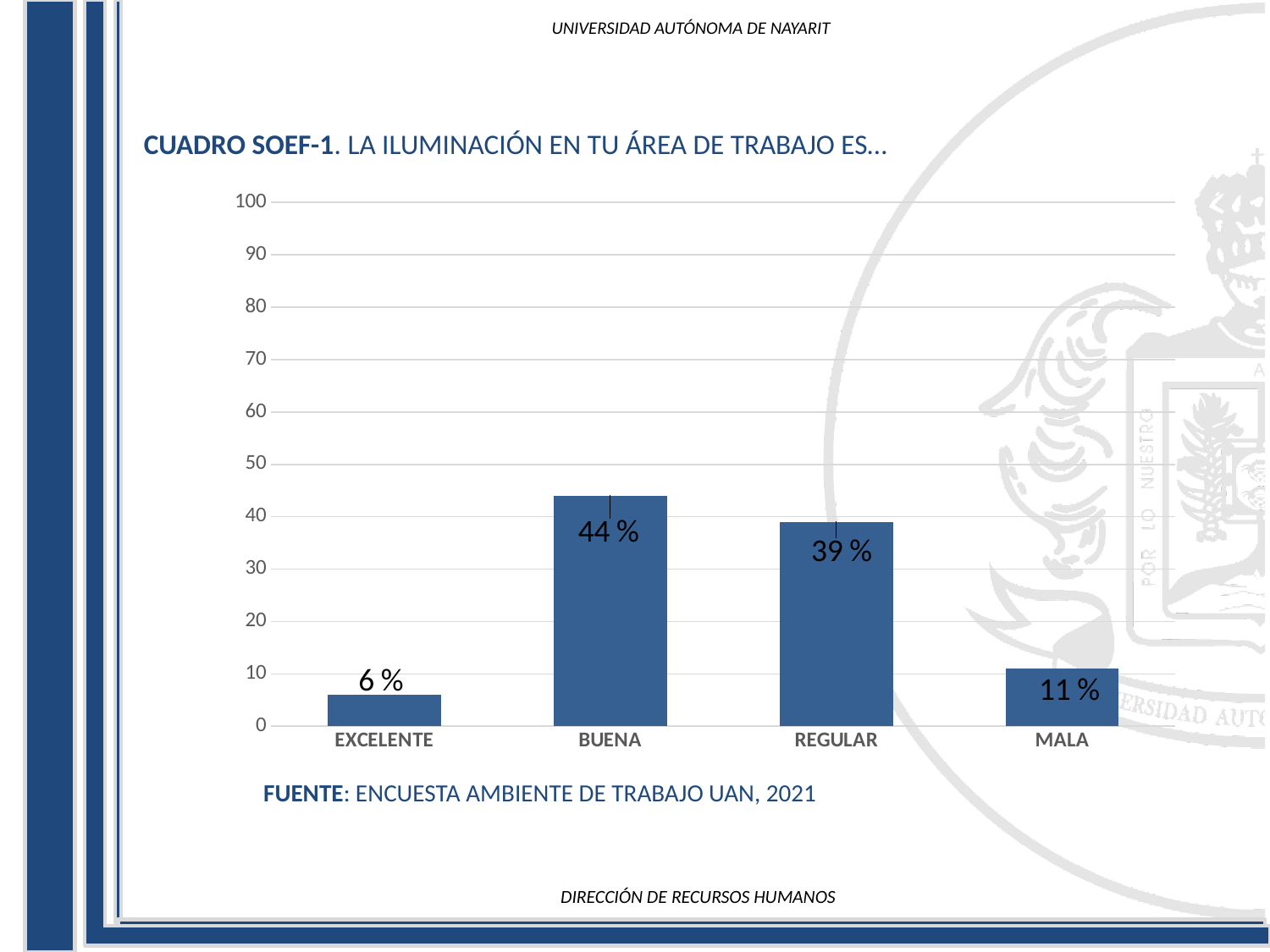
Which is larger, the value for MALA or the value for EXCELENTE? MALA Which category has the lowest value? EXCELENTE How many categories are shown on the x axis? 4 What is the value for BUENA? 44 % What kind of chart is shown on the slide? bar chart What is the value for EXCELENTE? 6 % What is the difference between the values for BUENA and REGULAR? 5 % What is the value for REGULAR? 39 % Which category has the highest value? BUENA What is the title of the chart? CUADRO SOEF-1. LA ILUMINACIÓN EN TU ÁREA DE TRABAJO ES… What is the value for MALA? 11 % Is the value for REGULAR greater or less than 30? greater